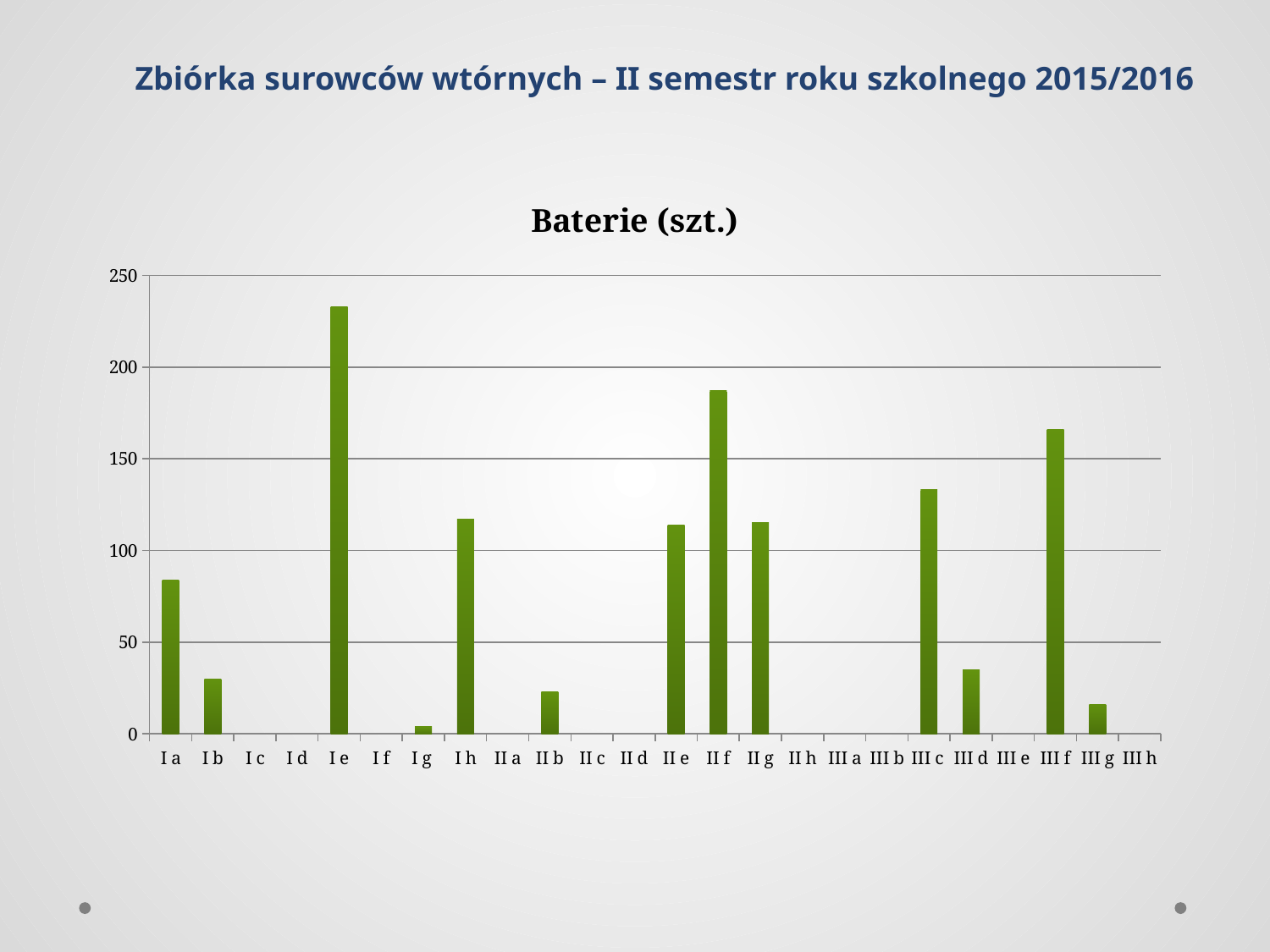
Is the value for II f greater or less than 200? less Is the value for III f greater or less than 150? greater Which category has the highest value in the chart? I e What kind of chart is shown on the slide? bar chart How many categories are shown on the x axis of the chart? 24 Which is larger, the value for I a or the value for I b? I a What is the title of the chart? Baterie (szt.) Is the value for I e greater or less than 200? greater Which is larger, the value for II f or the value for III f? II f Which is larger, the value for I h or the value for III d? I h